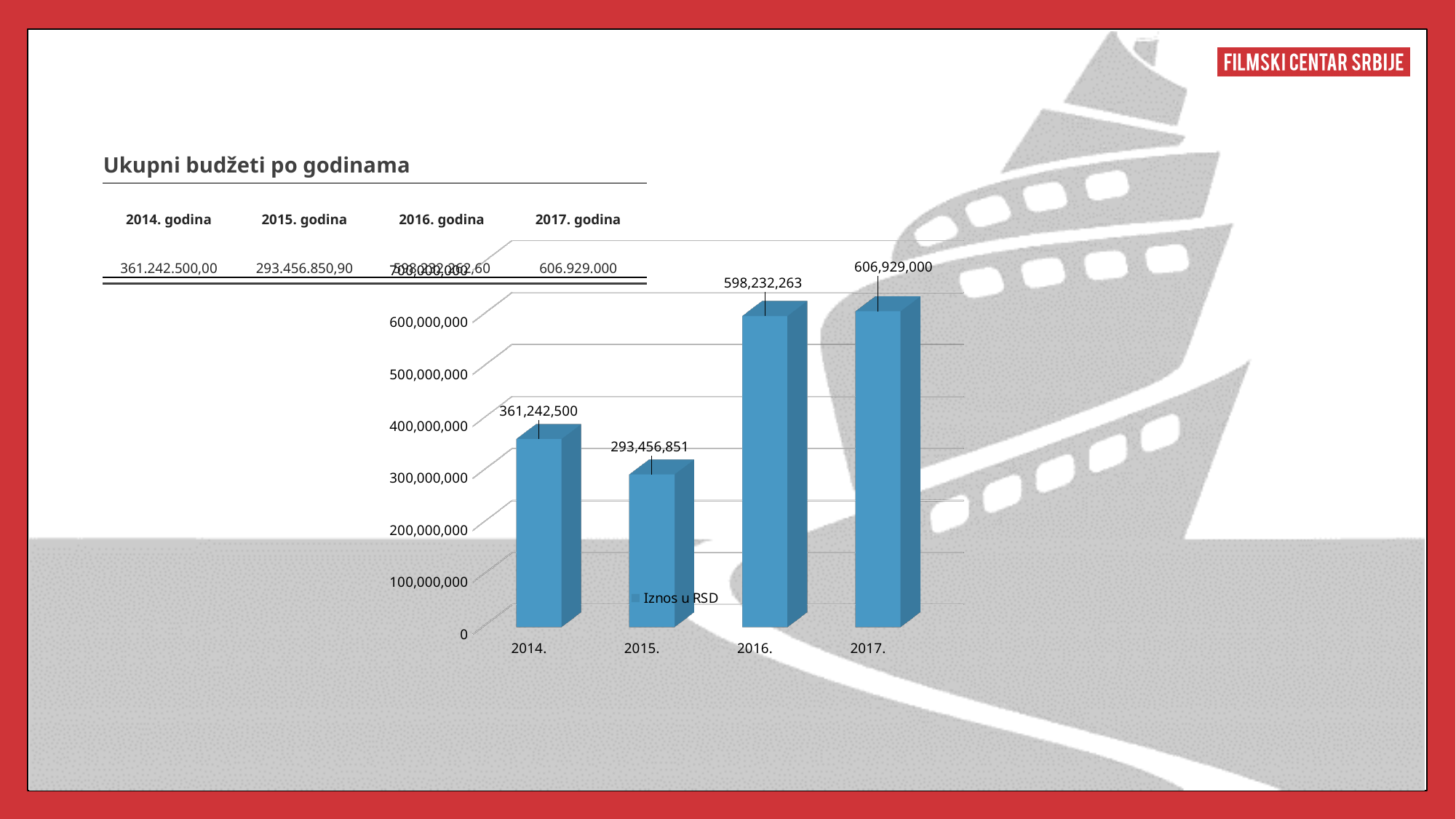
What is the value of the bar for 2016.? 598,232,263 What kind of chart is shown on the slide? bar chart What is the value of the bar for 2017.? 606,929,000 What series name does the chart legend show? Iznos u RSD How many bars are shown in the chart? 4 Which year has the lowest bar? 2015. Is the value for 2015. greater or less than 300,000,000? less What is the difference between the values for 2014. and 2015.? 67,785,649 Which year has the highest bar? 2017. What is the value of the bar for 2014.? 361,242,500 What is the value of the bar for 2015.? 293,456,851 Which is larger, the value for 2016. or the value for 2014.? 2016.